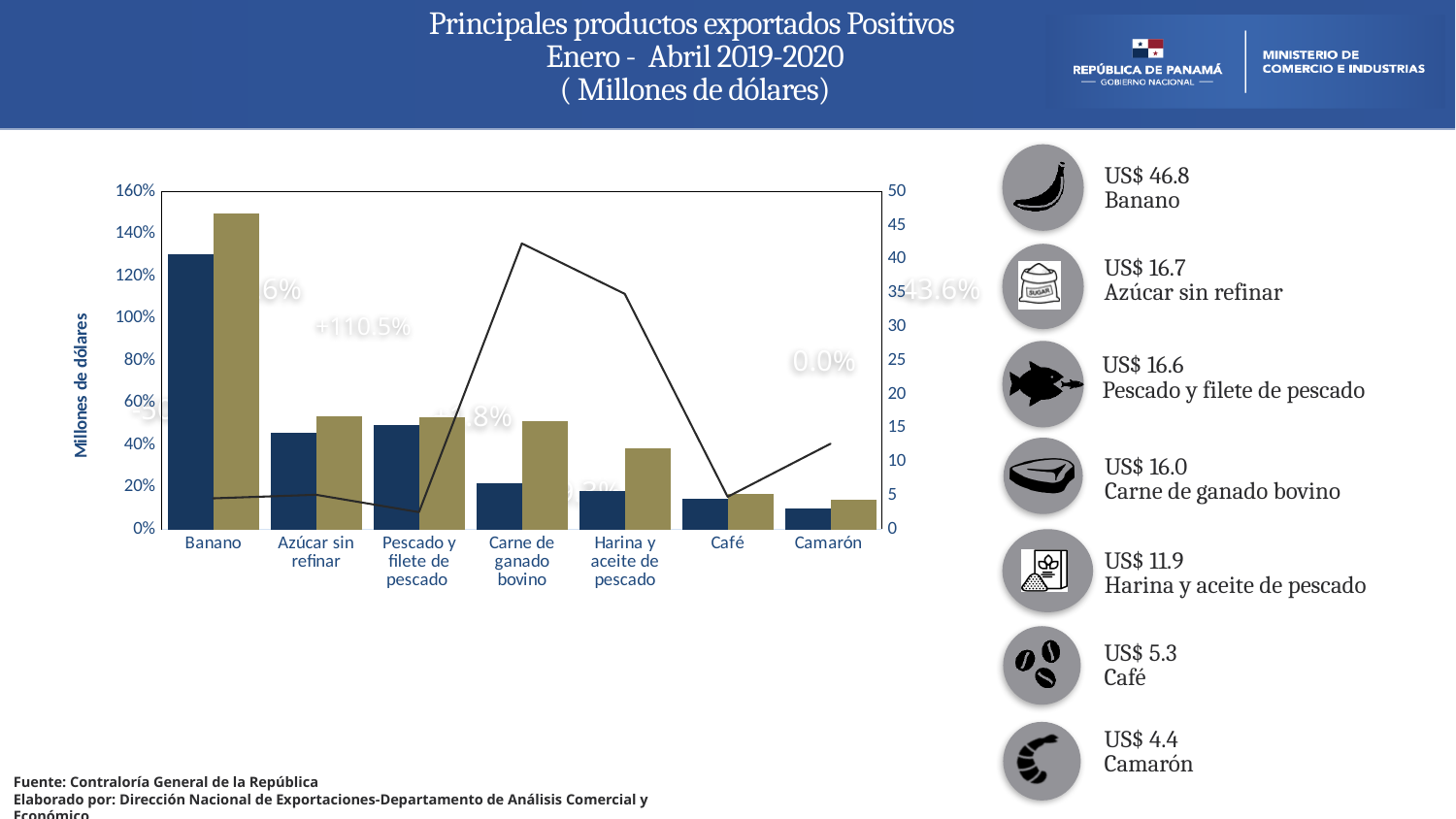
Which has the taller dark blue bar, Banano or Azúcar sin refinar? Banano Which product has the tallest bars in the chart? Banano What is the title of the chart on the slide? Principales productos exportados Positivos Enero - Abril 2019-2020 ( Millones de dólares) At which product does the line series reach its highest point? Carne de ganado bovino Is the olive-coloured bar for Banano greater or less than 40 on the right axis? greater How many product categories are shown on the x axis of the chart? 7 What is the label on the left vertical axis of the chart? Millones de dólares What type of chart is shown on the slide? Combination bar and line chart How many bars are plotted for each product category? 2 Is the olive-coloured bar for Café greater or less than 10 on the right axis? less Which has the taller olive-coloured bar, Carne de ganado bovino or Harina y aceite de pescado? Carne de ganado bovino Is the dark blue bar for Carne de ganado bovino greater or less than 10 on the right axis? less